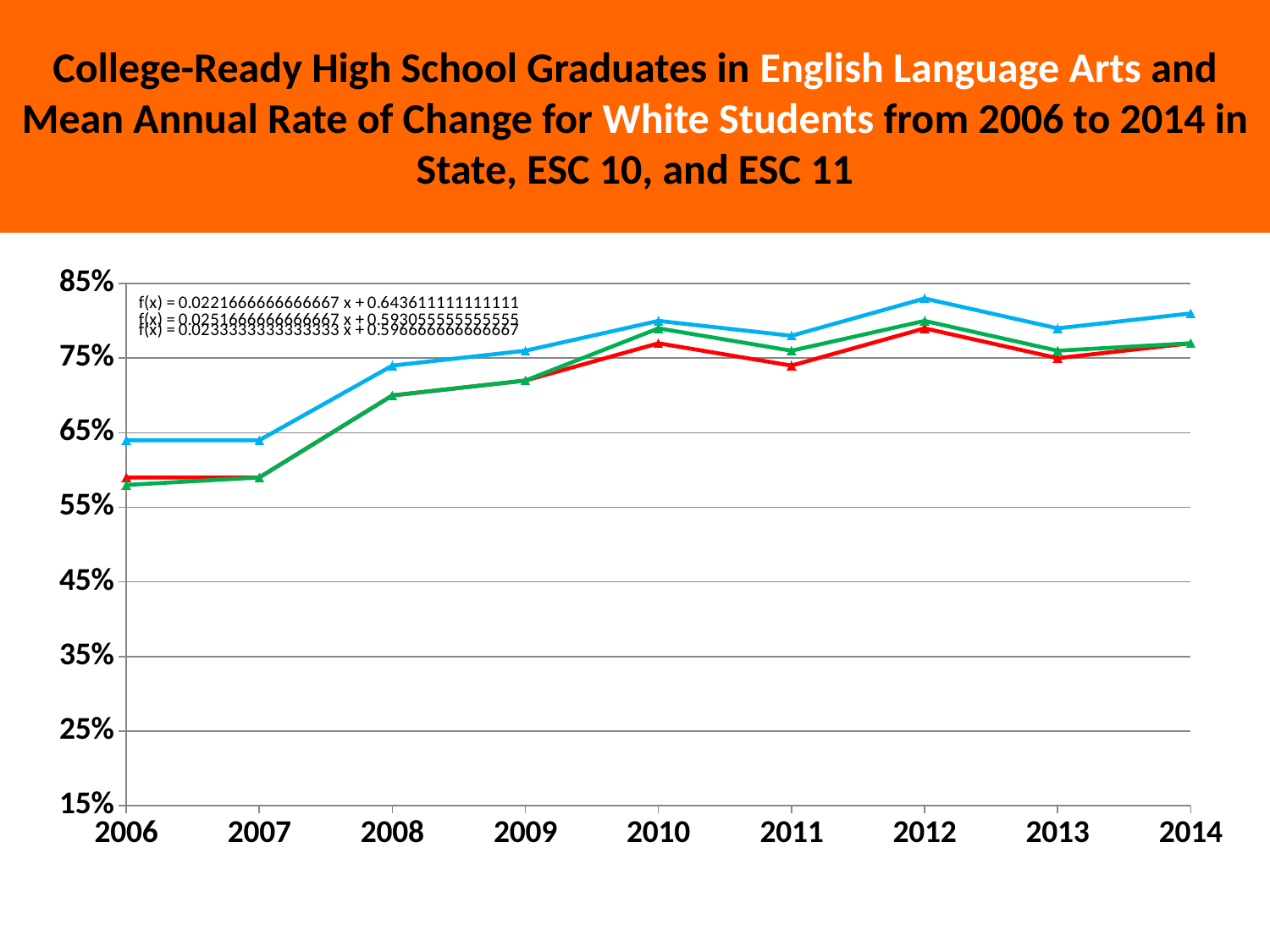
What is the highest value shown on the y axis of the chart? 85% What kind of chart is shown on the slide? line chart In which year does the blue line reach its highest value? 2012 In 2010, which line has the higher value, the blue line or the red line? the blue line Which year is the first on the x axis of the chart? 2006 Is the value of the red line in 2006 greater or less than 55%? greater Overall, do the plotted lines rise or fall from 2006 to 2014? rise Is the value of the green line in 2006 greater or less than 65%? less How many years are plotted along the x axis of the chart? 9 Is the value of the green line in 2008 greater or less than 65%? greater